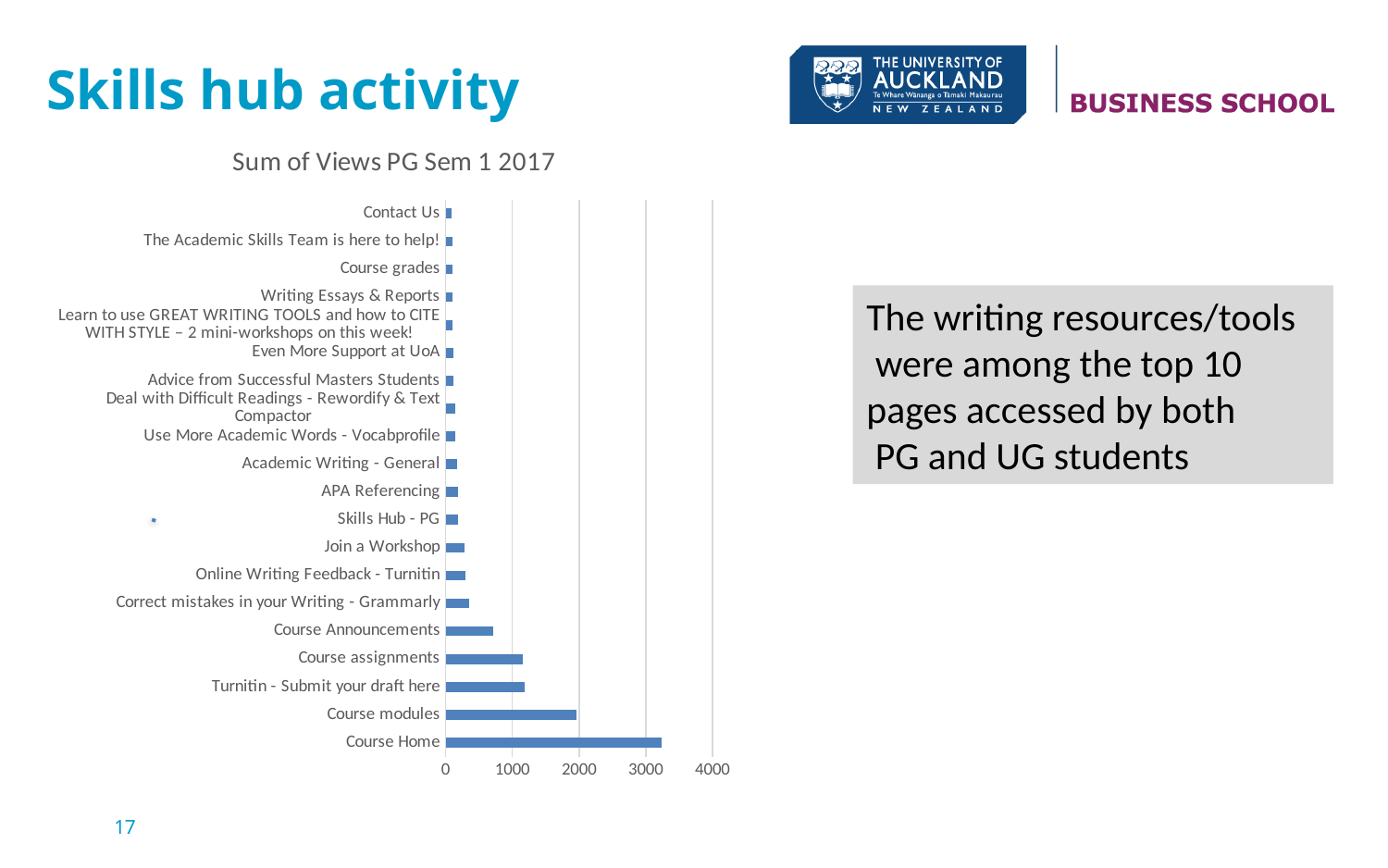
Is the value for Turnitin - Submit your draft here greater or less than 1000? greater Is the value for Course Announcements greater or less than 1000? less What type of chart is shown on the slide? Bar chart What is the maximum value shown on the horizontal axis? 4000 Which has more views, Course Announcements or Course assignments? Course assignments Which has more views, Course Home or Course modules? Course Home How many pages (categories) are plotted in the chart? 20 Which page has the highest sum of views? Course Home What is the title of the chart? Sum of Views PG Sem 1 2017 Is the value for Course Home greater or less than 3000? greater